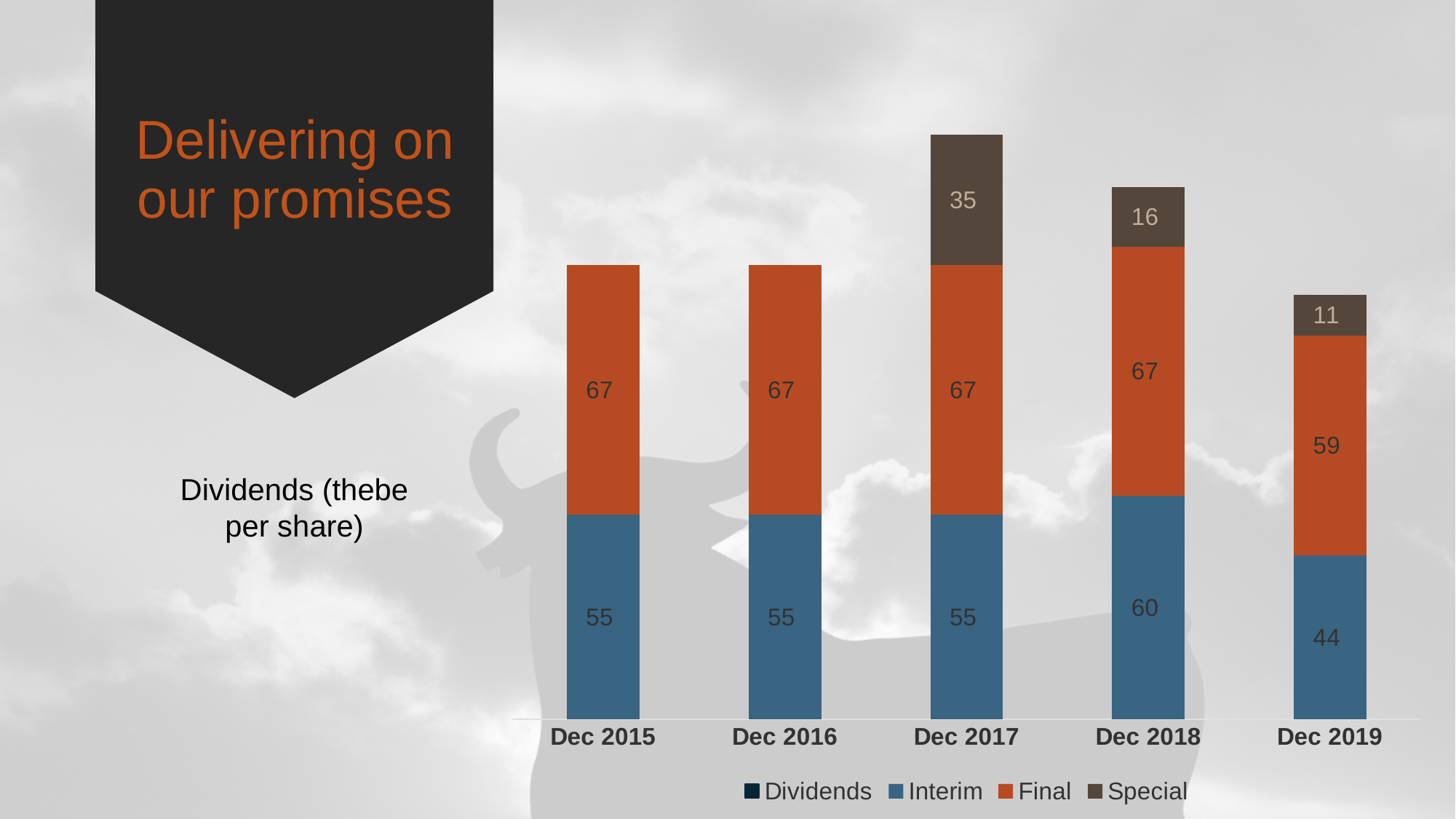
What is the total of the stacked bar for Dec 2019? 114 What is the difference between the Special dividend in Dec 2017 and Dec 2018? 19 Which year has the highest Special dividend? Dec 2017 How many series does the legend list? 4 What is the total of the stacked bar for Dec 2017? 157 What is the Interim dividend value for Dec 2015? 55 Is the Interim dividend larger in Dec 2018 or Dec 2019? Dec 2018 How many years are shown on the x axis? 5 What is the Special dividend value for Dec 2017? 35 What is the Interim dividend value for Dec 2018? 60 What is the Final dividend value for Dec 2019? 59 Which year has the lowest Interim dividend? Dec 2019